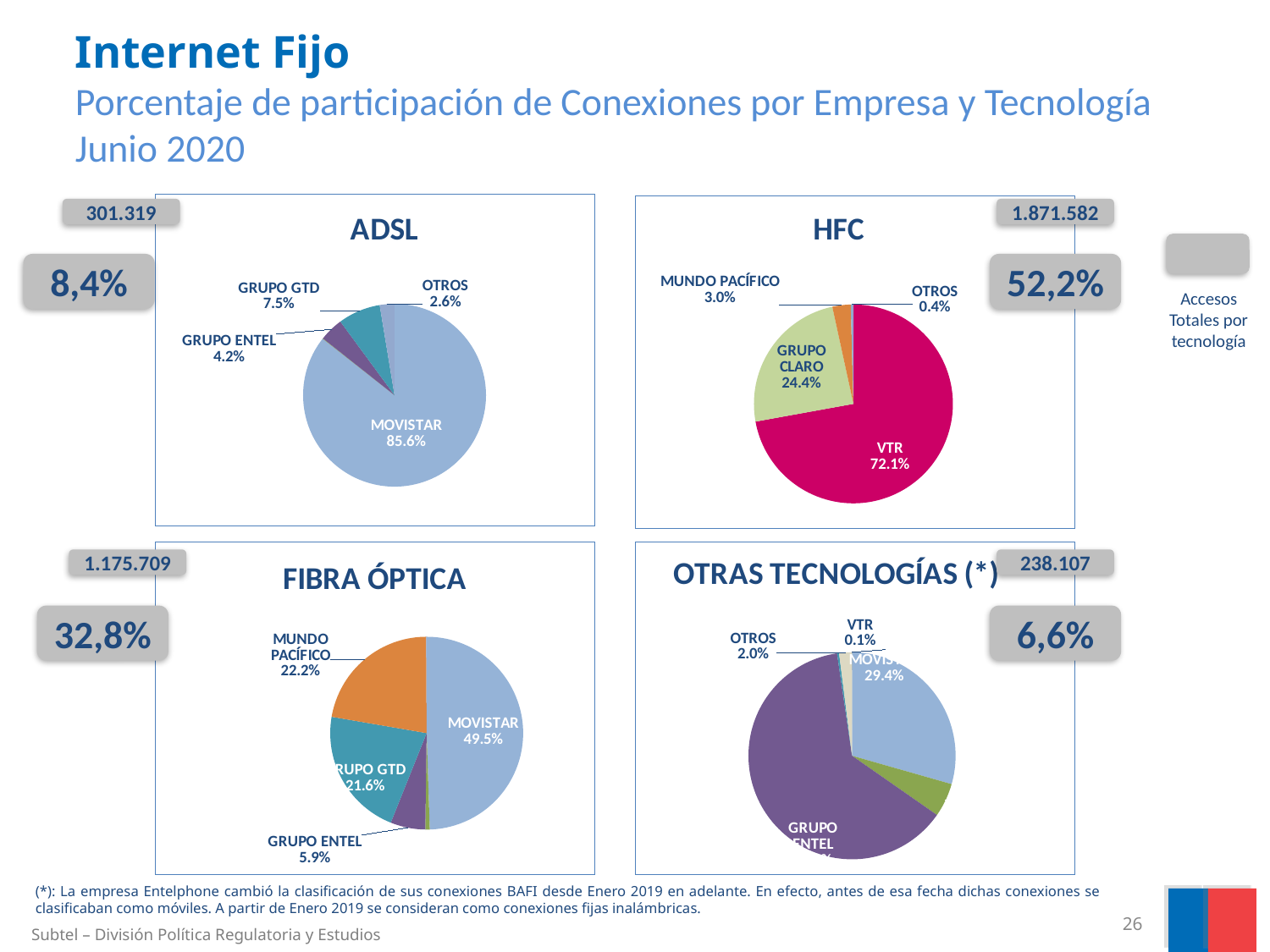
In the HFC chart, what is the share for GRUPO CLARO? 24.4% What percentage of total accesses is attributed to FIBRA ÓPTICA? 32,8% In the HFC chart, which company has the largest share? VTR In the HFC chart, which is larger: the share of MUNDO PACÍFICO or the share of OTROS? MUNDO PACÍFICO In the FIBRA ÓPTICA chart, what is the difference between the MOVISTAR share and the GRUPO GTD share? 27.9 percentage points In the FIBRA ÓPTICA chart, what is the share for MUNDO PACÍFICO? 22.2% In the OTRAS TECNOLOGÍAS (*) chart, what is the share for VTR? 0.1% In the ADSL chart, which category has the smallest share? OTROS What is the total number of accesses shown for the HFC technology? 1.871.582 In the ADSL chart, what share of connections does MOVISTAR hold? 85.6% What type of chart is used for the ADSL data? Pie chart How many labelled categories are shown in the HFC pie chart? 4